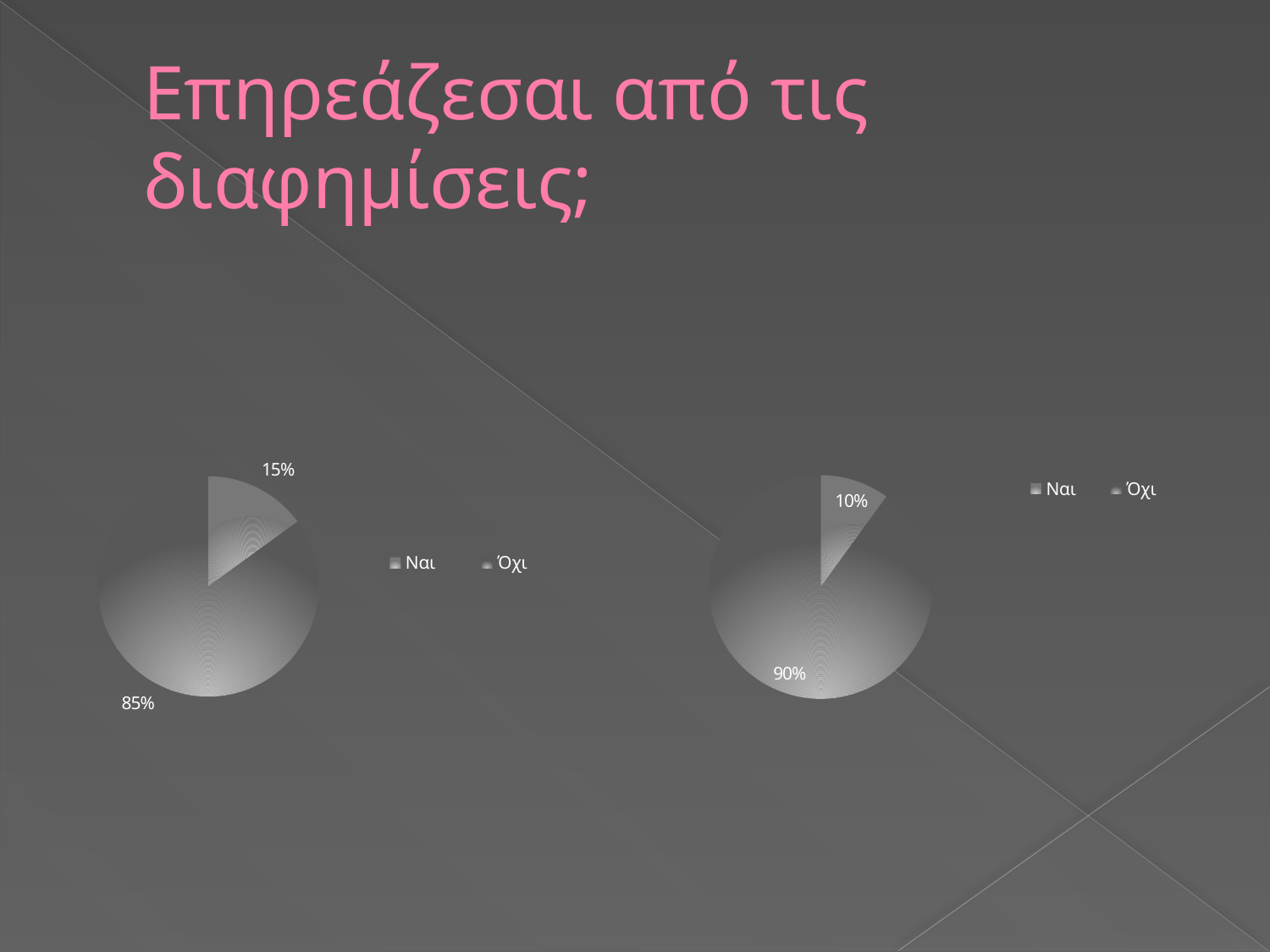
What are the two legend entries shown for the right pie chart? Ναι and Όχι What kind of chart is the left chart on the slide? pie chart In the left pie chart, what percentage is shown on the larger slice? 85% In the right pie chart, what percentage is shown on the smaller slice? 10% Which chart has the larger smaller-slice percentage, the left pie chart or the right pie chart? the left pie chart In the left pie chart, what is the difference between the larger and smaller slice percentages? 70% In the left pie chart, what percentage is shown on the smaller slice? 15% How many slices does the left pie chart have? 2 What kind of chart is the right chart on the slide? pie chart In the right pie chart, what percentage is shown on the larger slice? 90% How many slices does the right pie chart have? 2 How many entries does the legend of the left pie chart list? 2